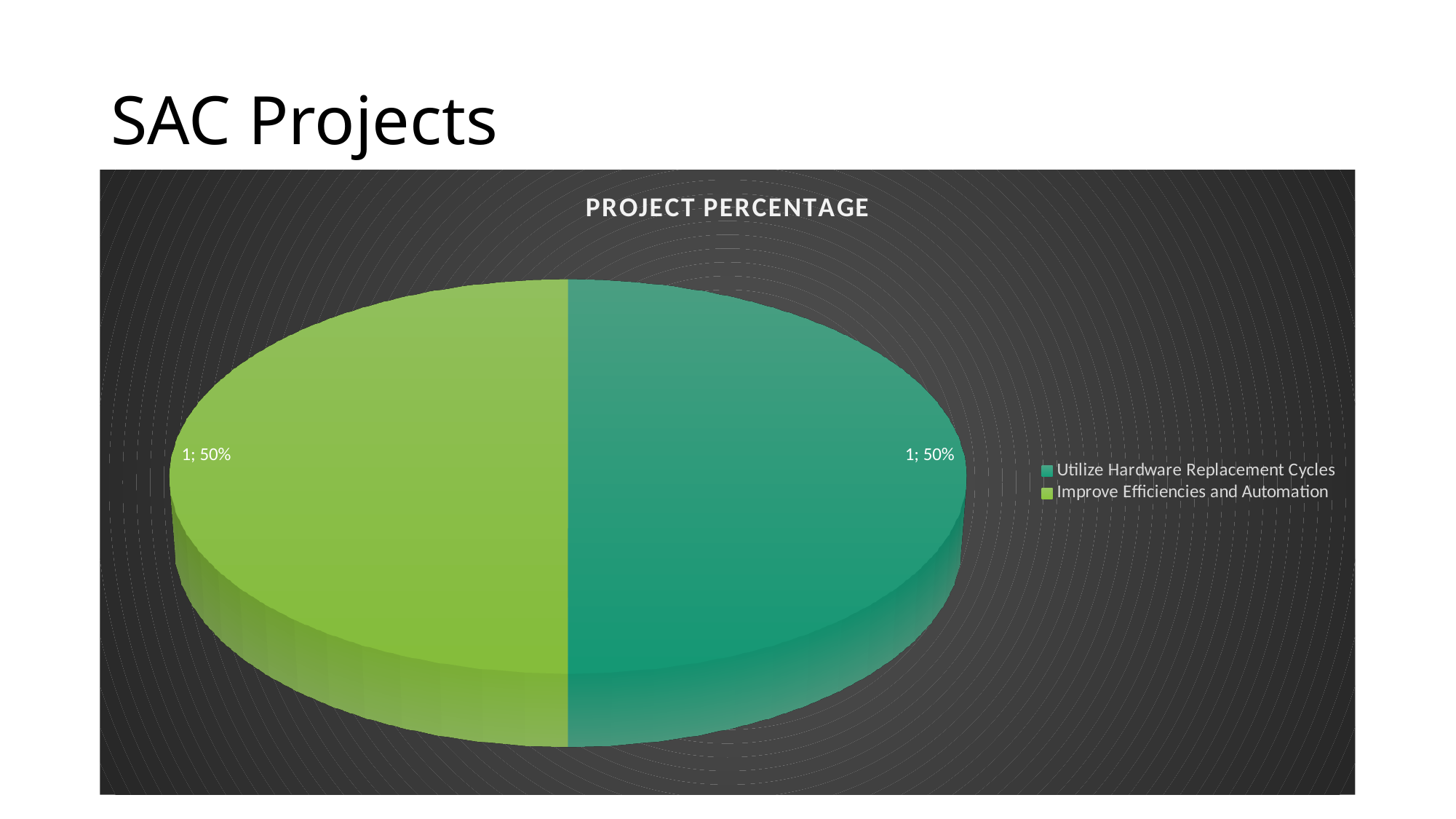
What is the title of the chart? PROJECT PERCENTAGE How many slices does the pie chart have? 2 What share of the pie does Improve Efficiencies and Automation represent? 50% What share of the pie does Utilize Hardware Replacement Cycles represent? 50% How many entries does the legend list? 2 What value is labelled on the Utilize Hardware Replacement Cycles slice? 1 What kind of chart is shown on the slide? Pie chart What value is labelled on the Improve Efficiencies and Automation slice? 1 Which legend entry is shown in light green? Improve Efficiencies and Automation What is the total of the values shown on the two slices? 2 What is the difference between the values for Utilize Hardware Replacement Cycles and Improve Efficiencies and Automation? 0